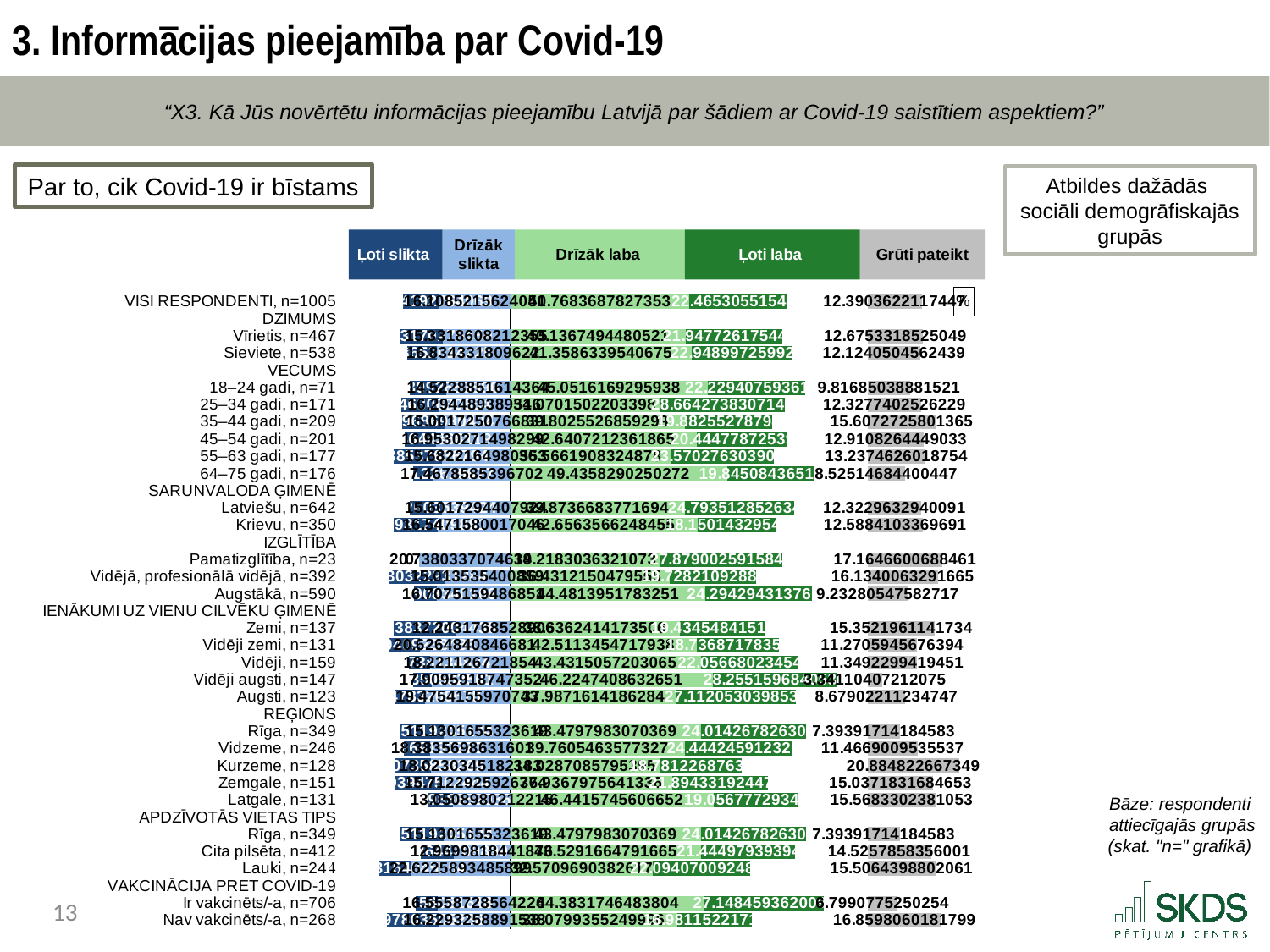
Which has the larger 'Ļoti laba' share: Ir vakcinēts/-a, n=706 or Nav vakcinēts/-a, n=268? Ir vakcinēts/-a, n=706 How many age groups (VECUMS) are plotted in the chart? 6 How many regions (REĢIONS) are plotted in the chart? 5 Which legend entry is shown in dark green? Ļoti laba Which has the larger 'Grūti pateikt' share: Kurzeme, n=128 or Rīga, n=349? Kurzeme, n=128 What kind of chart is shown on the slide? Stacked bar chart How many series does the chart legend list? 5 What is the sample size (n) for the 'VISI RESPONDENTI' row? 1005 What is the title shown above the chart? Par to, cik Covid-19 ir bīstams How many education groups (IZGLĪTĪBA) are plotted in the chart? 3